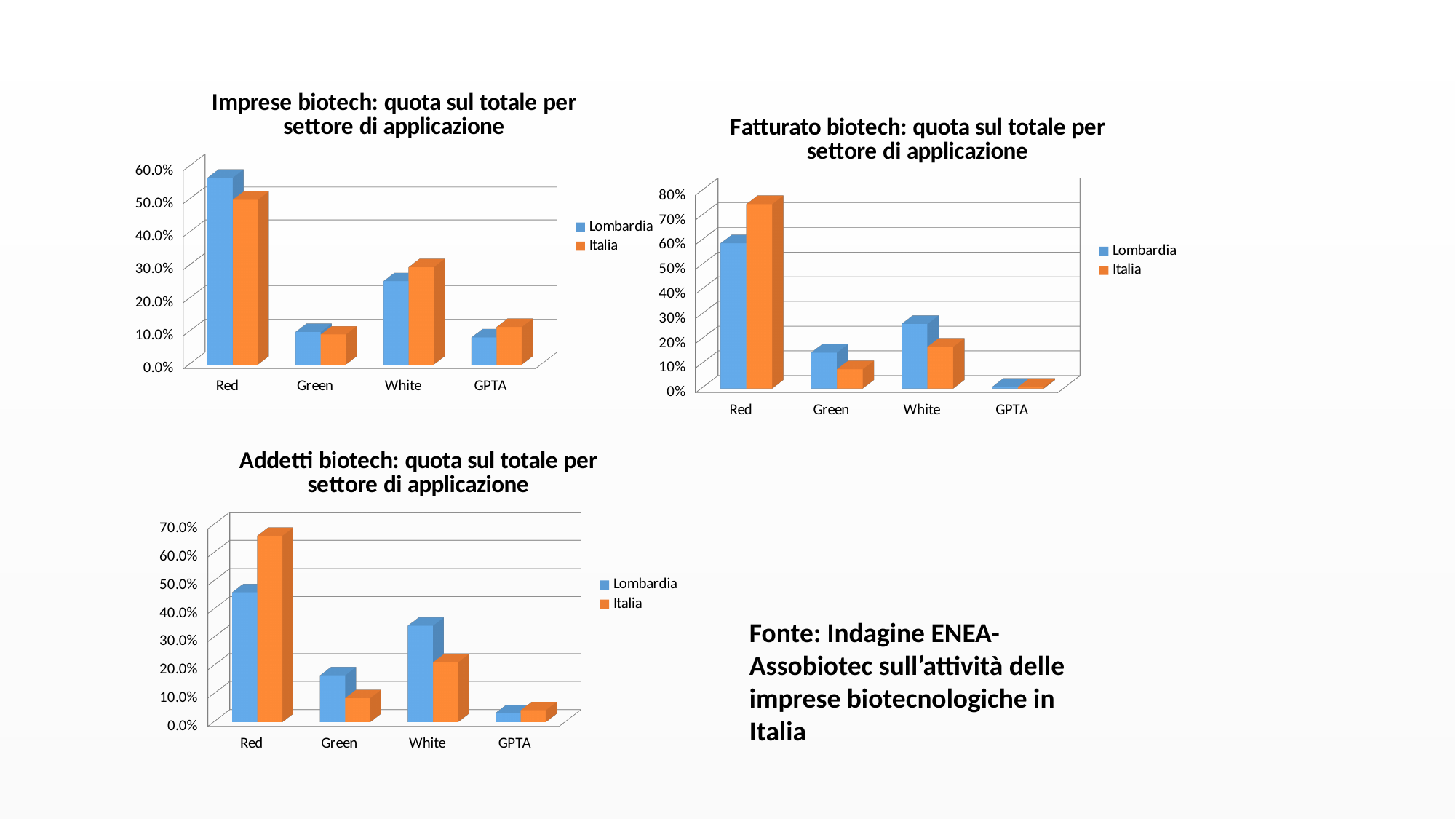
In the 'Imprese biotech' chart, which category has the highest value for Lombardia? Red In the 'Fatturato biotech' chart, which is larger for Green: Lombardia or Italia? Lombardia In the 'Addetti biotech' chart, which category has the lowest value for Lombardia? GPTA How many categories are shown on the x axis of the 'Addetti biotech' chart? 4 In the 'Fatturato biotech' chart, which category has the lowest value for Italia? GPTA In the 'Fatturato biotech' chart, is the Italia value for Red greater or less than 70%? greater What kind of chart is the 'Imprese biotech' chart? Bar chart In the 'Addetti biotech' chart, which is larger for White: Lombardia or Italia? Lombardia In the 'Imprese biotech' chart, is the Lombardia value for Red greater or less than 50%? greater How many series does the legend of the 'Fatturato biotech' chart list? 2 In the 'Addetti biotech' chart, is the Italia value for Red greater or less than 60%? greater In the 'Imprese biotech' chart, which is larger for White: Lombardia or Italia? Italia